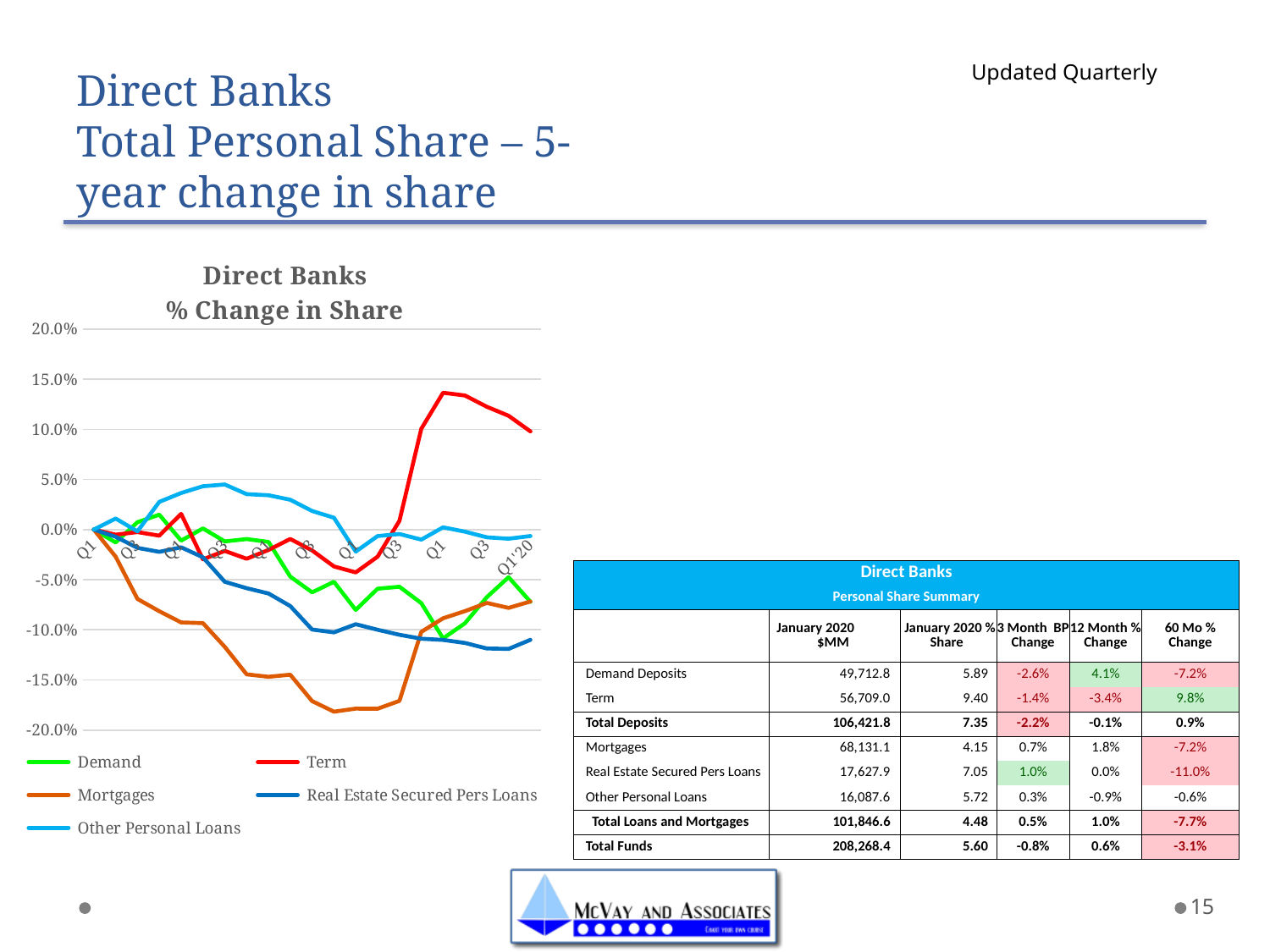
What kind of chart is shown on the slide? line chart Which series reaches the lowest value anywhere on the chart? Mortgages Is the value of the Real Estate Secured Pers Loans line at the final point (Q1'20) greater or less than -10.0%? less Is the highest value reached by the Other Personal Loans line greater or less than 5.0%? less What is the title of the chart? Direct Banks % Change in Share Does the Real Estate Secured Pers Loans line generally rise or fall across the period shown? fall How many series does the legend of the chart list? 5 At the final point (Q1'20), which is larger: the Term value or the Demand value? Term Which colour is used for the Term line in the chart? red Is the lowest value of the Mortgages line greater or less than -15.0%? less Which series has the highest value at the final point (Q1'20)? Term